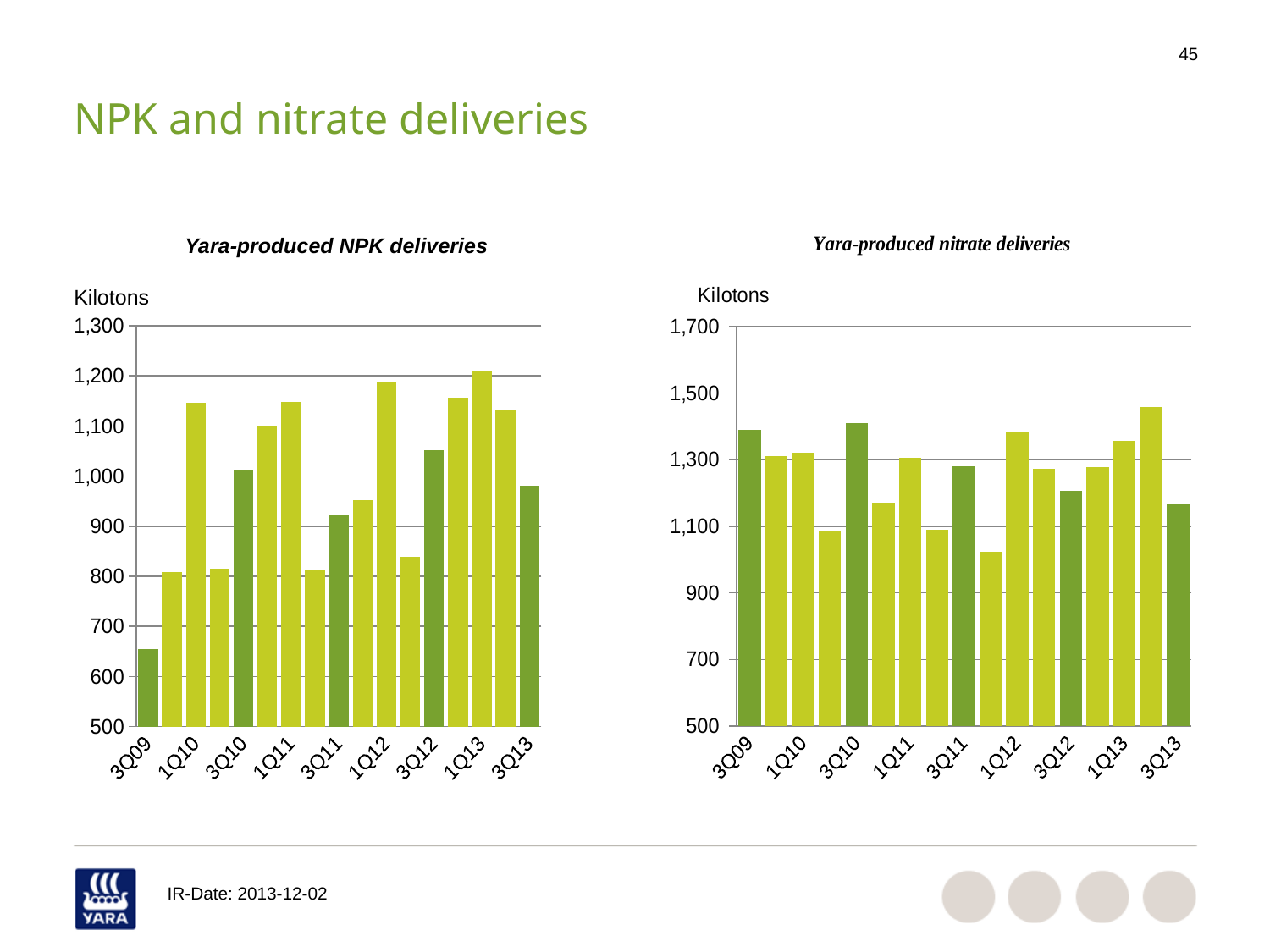
In the Yara-produced nitrate deliveries chart, is the value for 3Q13 greater or less than 1,300? less In the Yara-produced nitrate deliveries chart, which is larger, the value for 3Q10 or the value for 3Q13? 3Q10 In the Yara-produced NPK deliveries chart, is the value for 3Q09 greater or less than 700? less In the Yara-produced NPK deliveries chart, which is larger, the value for 1Q10 or the value for 3Q10? 1Q10 In the Yara-produced NPK deliveries chart, is the value for 1Q10 greater or less than 1,100? greater How many bars are plotted in the Yara-produced nitrate deliveries chart? 17 In the Yara-produced NPK deliveries chart, does the value rise or fall from 3Q09 to 3Q13? rise In the Yara-produced NPK deliveries chart, which quarter has the lowest value? 3Q09 What unit is shown on the y axis of both charts? Kilotons What kind of chart is the Yara-produced NPK deliveries chart? Bar chart